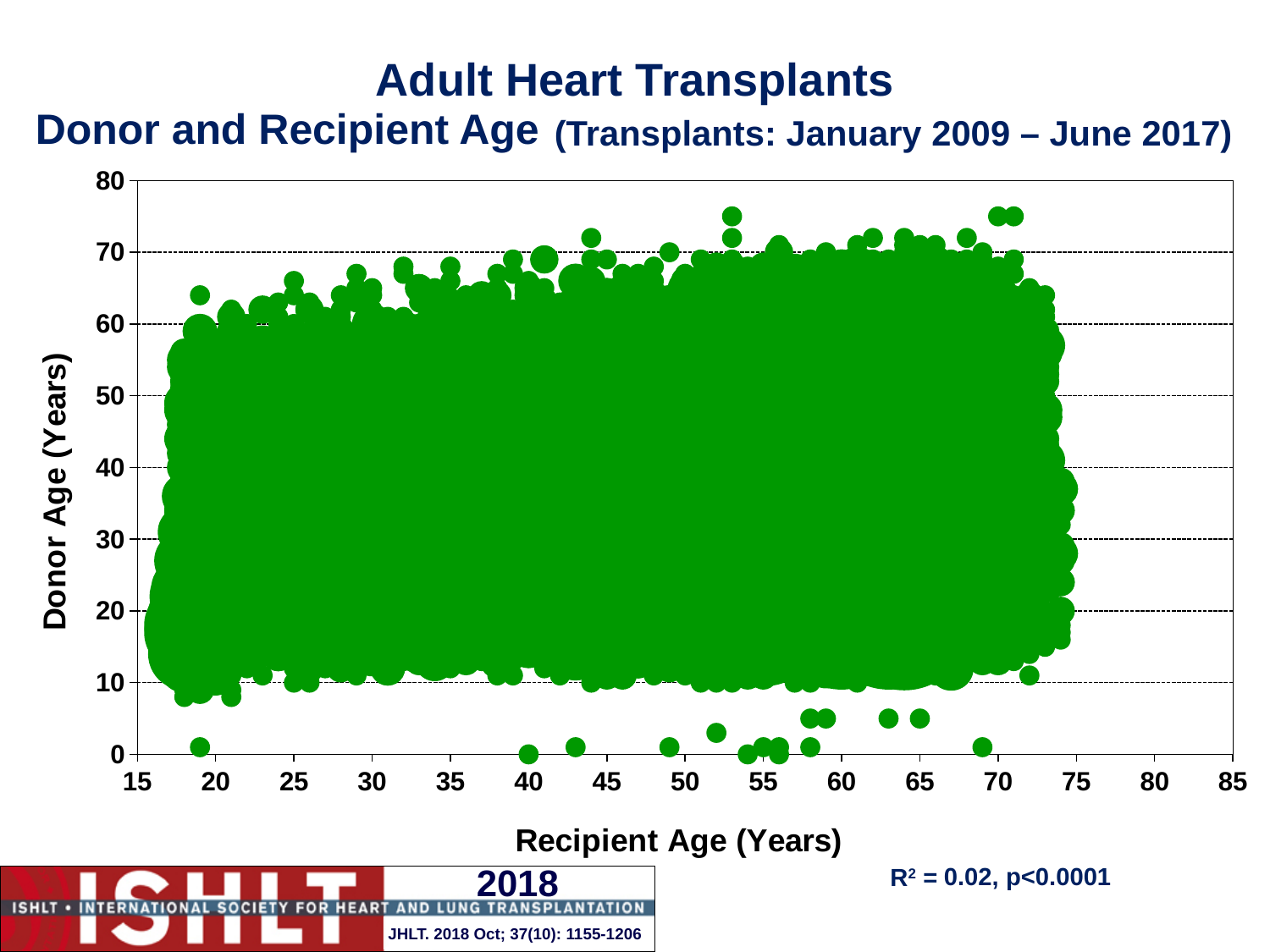
What p-value is printed on the slide? p<0.0001 Is the highest donor age plotted greater or less than 80? less Is the highest donor age plotted greater or less than 70? greater Is the highest recipient age plotted greater or less than 80? less What is the label of the vertical axis? Donor Age (Years) What kind of chart is shown on the slide? scatter plot What is the maximum value shown on the horizontal axis? 85 What is the R² value printed on the slide? 0.02 What is the label of the horizontal axis? Recipient Age (Years) What is the maximum value shown on the vertical axis? 80